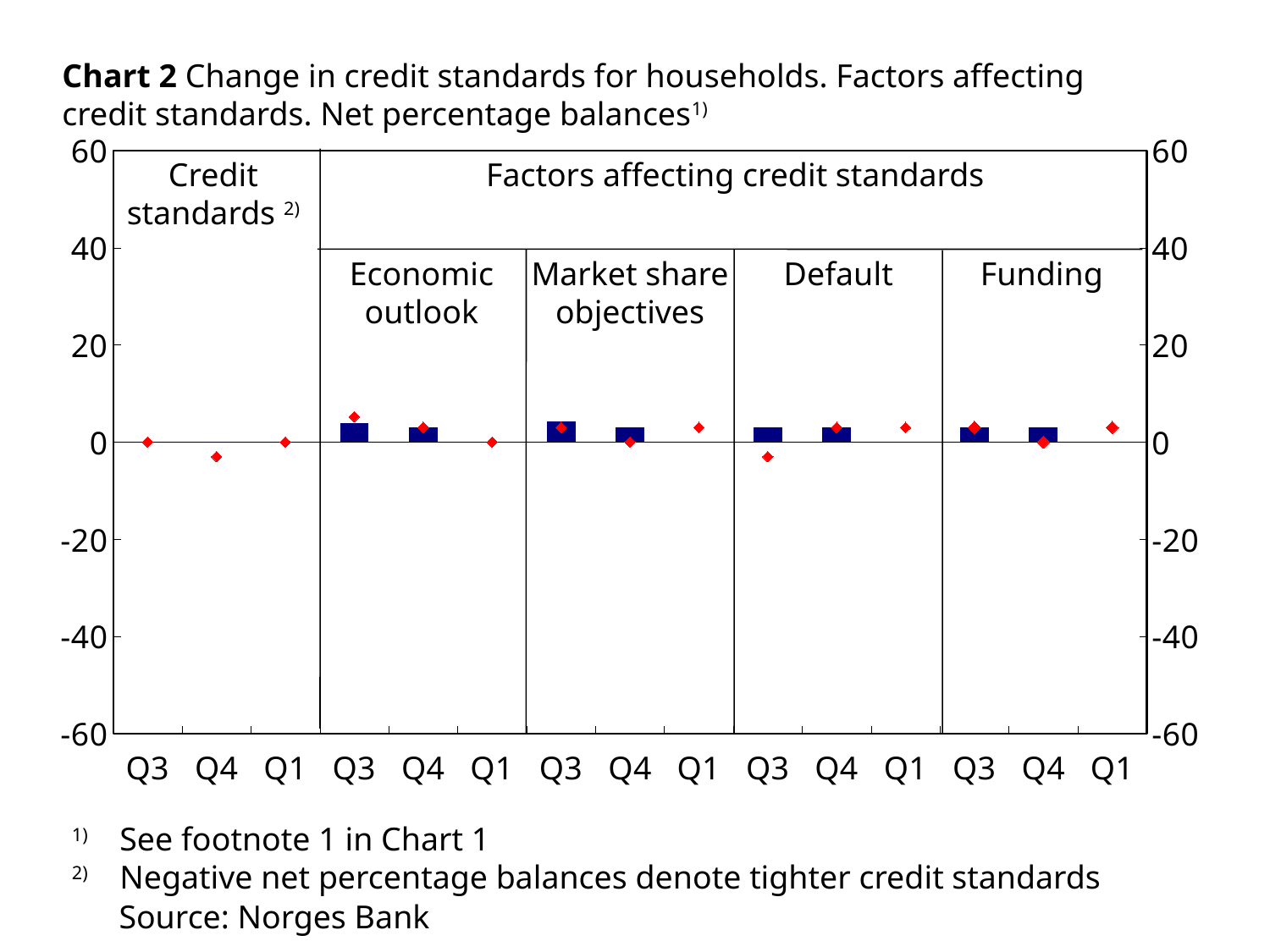
Is the value for Funding in Q1 greater or less than -20? greater How many x-axis category labels are there in total across the chart? 15 What is the source given for the chart? Norges Bank Is the value for Economic outlook in Q3 greater or less than 20? less Is the value for Default in Q4 greater or less than 20? less How many quarters are plotted in each panel of the chart? 3 How many factors affecting credit standards are shown as separate panels in the chart? 4 What is the title of the chart? Chart 2 Change in credit standards for households. Factors affecting credit standards. Net percentage balances What kind of chart is shown on the slide? combination bar and line chart (bars with diamond markers)